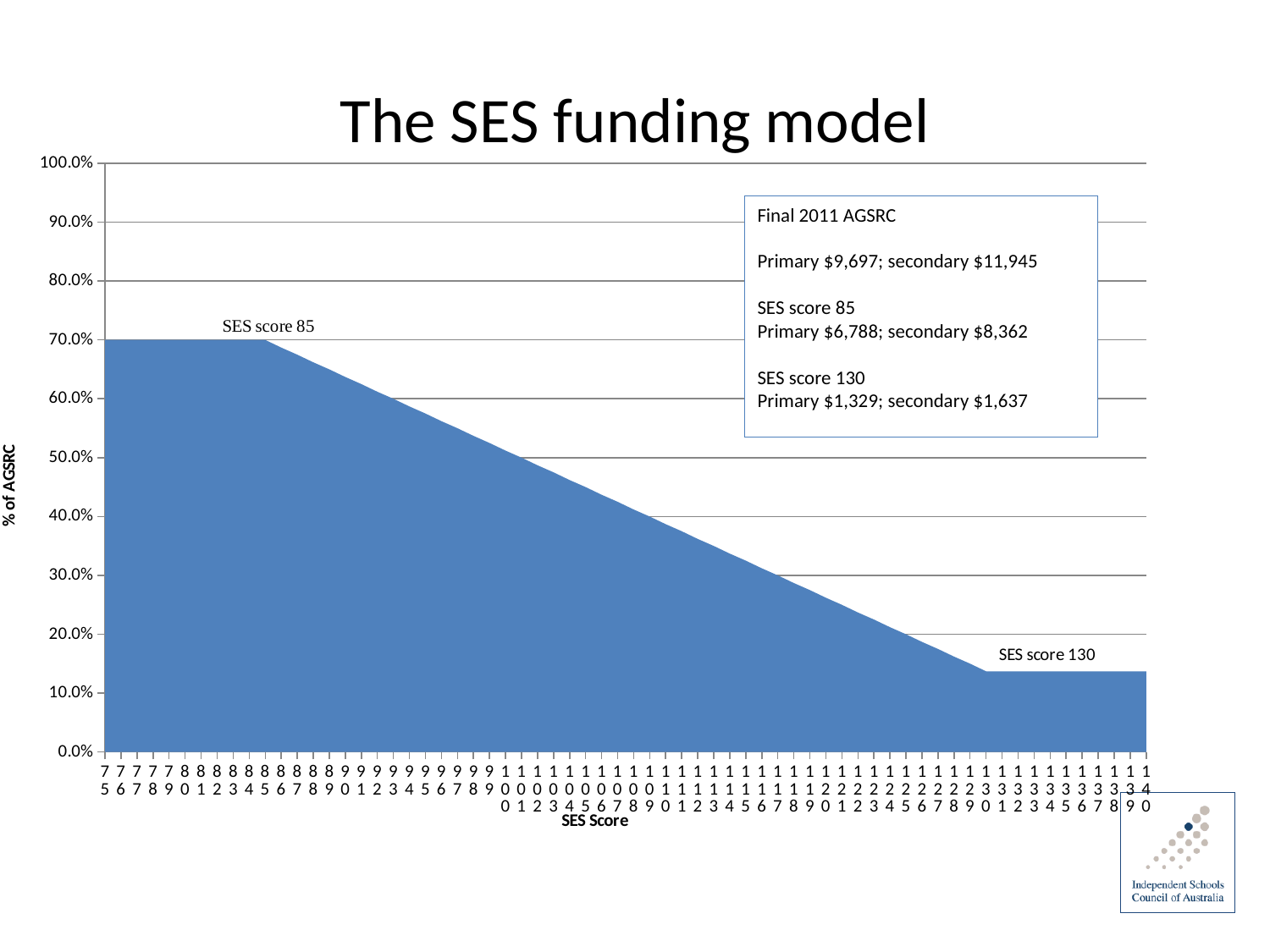
Is the % of AGSRC at SES score 90 greater or less than 60.0%? greater Is the % of AGSRC at SES score 120 greater or less than 30.0%? less What is the % of AGSRC at SES score 75? 70.0% What kind of chart is shown on the slide? area chart What is the % of AGSRC at SES score 85? 70.0% What is the highest % of AGSRC shown in the chart? 70.0% What is the label of the x axis? SES Score Does the % of AGSRC rise or fall as the SES score increases from 85 to 130? fall What is the title of the chart? The SES funding model According to the text box on the chart, what is the primary funding amount at SES score 130? $1,329 Is the % of AGSRC at SES score 110 greater or less than 50.0%? less